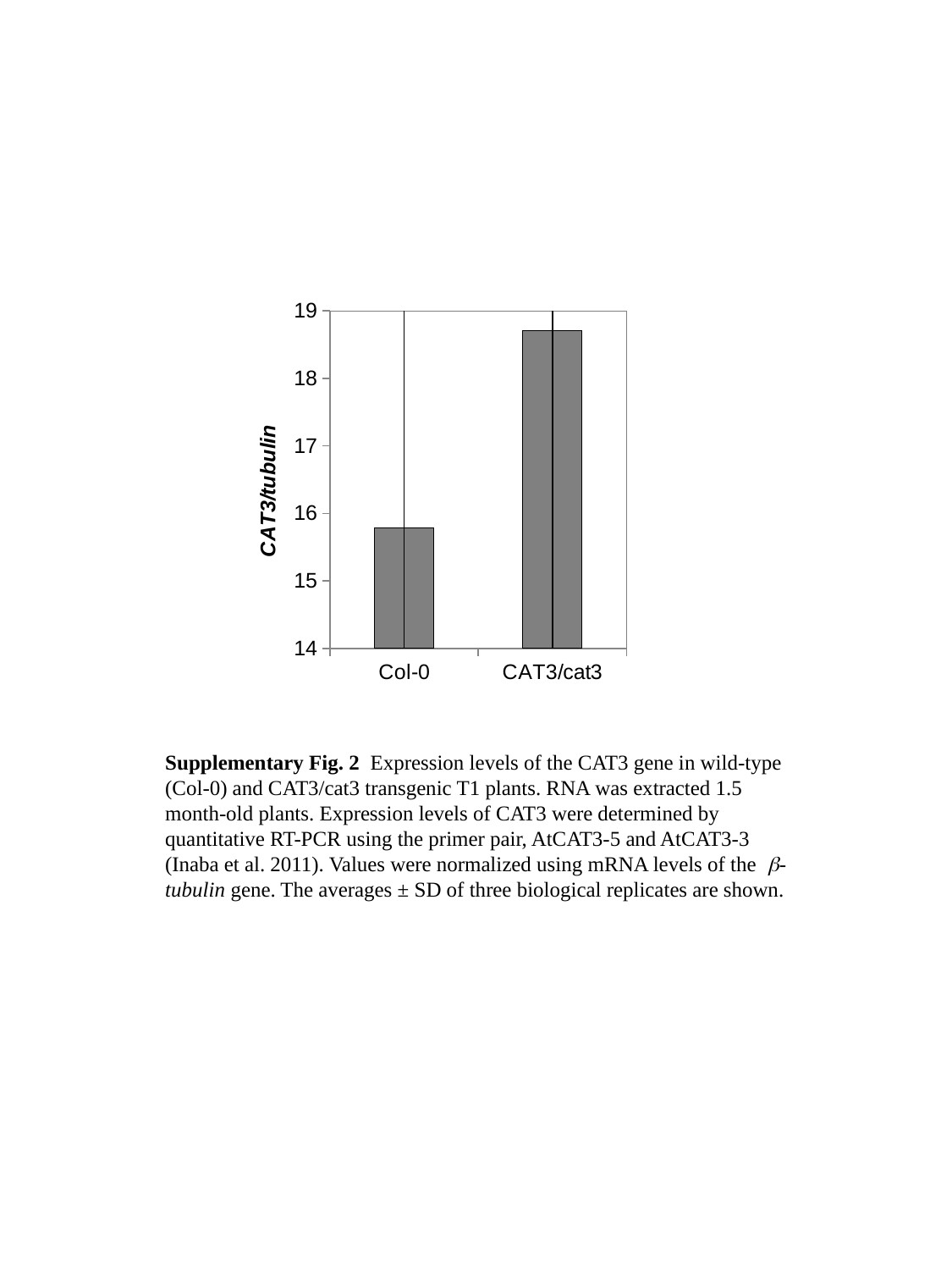
What is the label of the y axis? CAT3/tubulin Which category has the highest CAT3/tubulin value? CAT3/cat3 What kind of chart is shown on the slide? bar chart What is the lowest value shown on the y axis? 14 How many categories are plotted on the x axis? 2 Which is larger, the value for Col-0 or the value for CAT3/cat3? CAT3/cat3 Is the value for Col-0 greater or less than 16? less Is the value for Col-0 greater or less than 15? greater Which category has the lowest CAT3/tubulin value? Col-0 Is the value for CAT3/cat3 greater or less than 18? greater